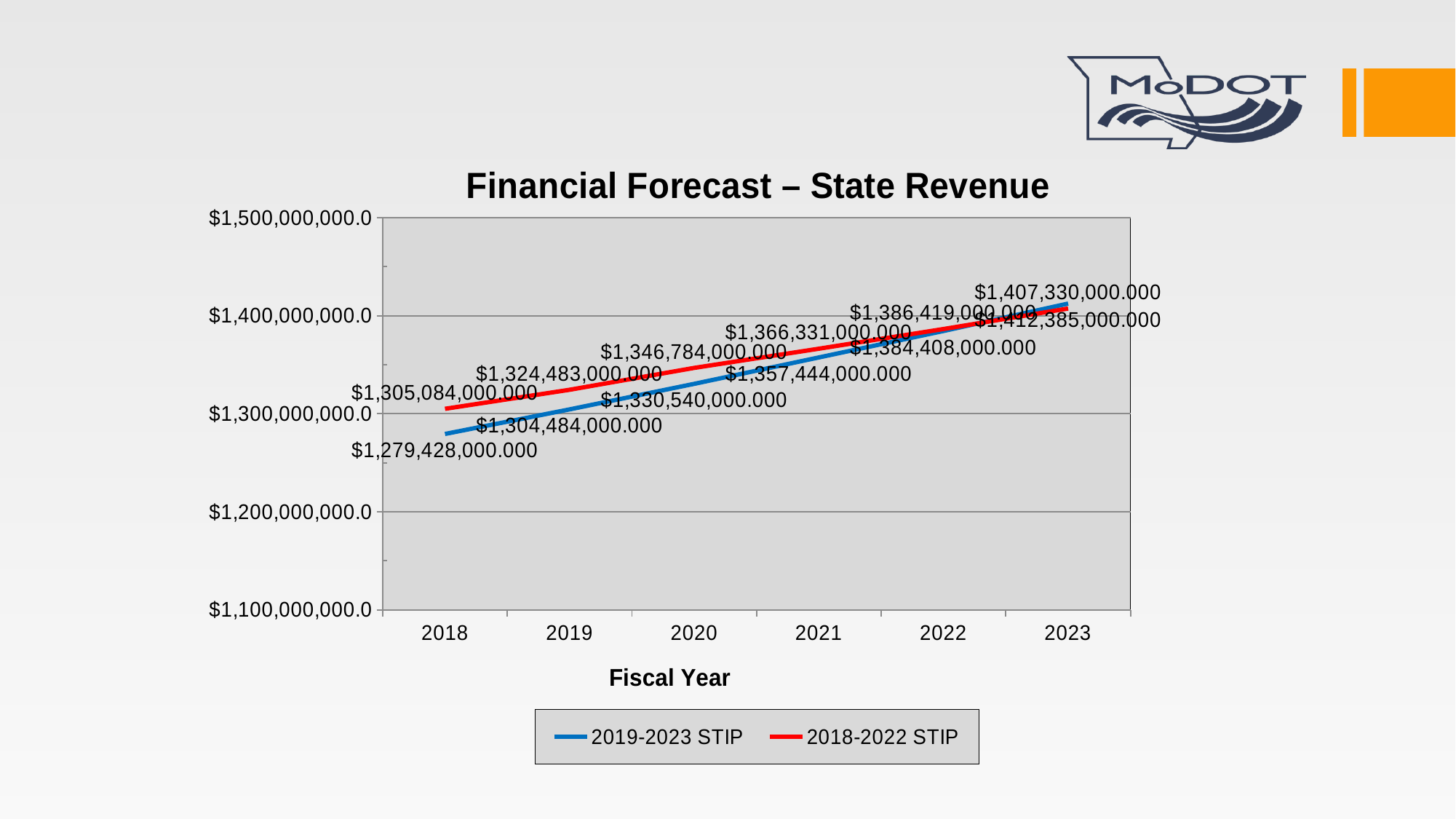
Which fiscal year has the lowest 2019-2023 STIP value? 2018 Which series has the higher value in fiscal year 2018, 2019-2023 STIP or 2018-2022 STIP? 2018-2022 STIP What is the title of the chart? Financial Forecast – State Revenue How many fiscal years are plotted on the x axis? 6 What is the difference between the 2018-2022 STIP and 2019-2023 STIP values in fiscal year 2018? $25,656,000.000 Do the 2019-2023 STIP values rise or fall from 2018 to 2023? Rise What kind of chart is shown on the slide? Line chart What is the 2018-2022 STIP value for fiscal year 2021? $1,366,331,000.000 What is the 2019-2023 STIP value for fiscal year 2018? $1,279,428,000.000 What is the 2018-2022 STIP value for fiscal year 2018? $1,305,084,000.000 How many series does the legend list? 2 What is the 2019-2023 STIP value for fiscal year 2020? $1,330,540,000.000